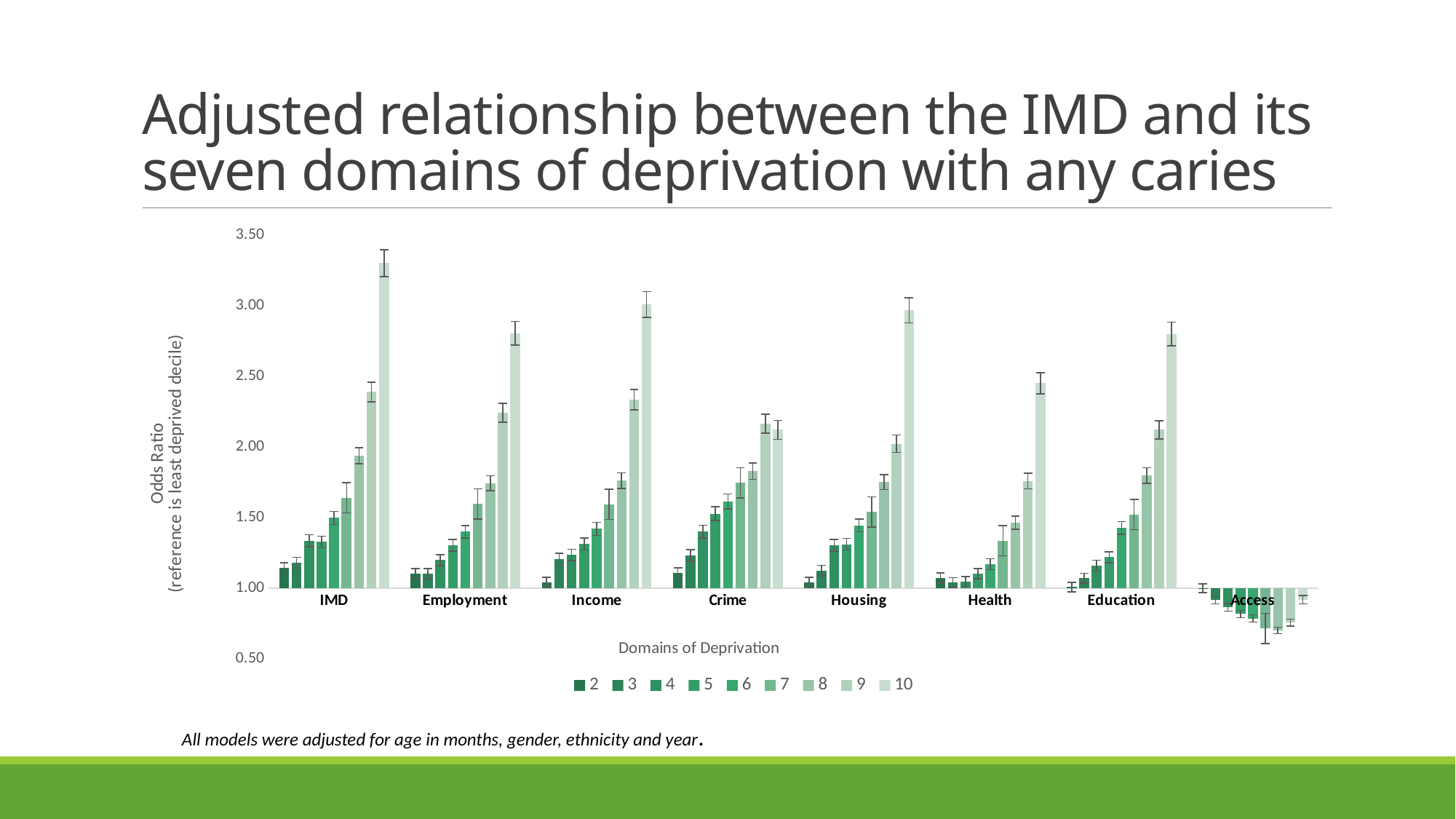
What is the label of the y axis? Odds Ratio (reference is least deprived decile) Which is larger: the decile 10 odds ratio for Crime or for Housing? Housing How many series does the legend list? 9 Is the odds ratio for decile 10 in the Education group greater or less than 3.00? less Is the odds ratio for decile 10 in the Access group greater or less than 1.00? less Within the IMD group, do the odds ratios rise or fall from decile 2 to decile 10? rise Which domain has the highest odds ratio for decile 10? IMD What kind of chart is shown on the slide? bar chart Is the odds ratio for decile 10 in the IMD group greater or less than 3.00? greater Which is larger: the decile 10 odds ratio for IMD or for Employment? IMD How many domain categories are shown along the x axis? 8 Which domain has the lowest odds ratios, with all bars below 1.00? Access